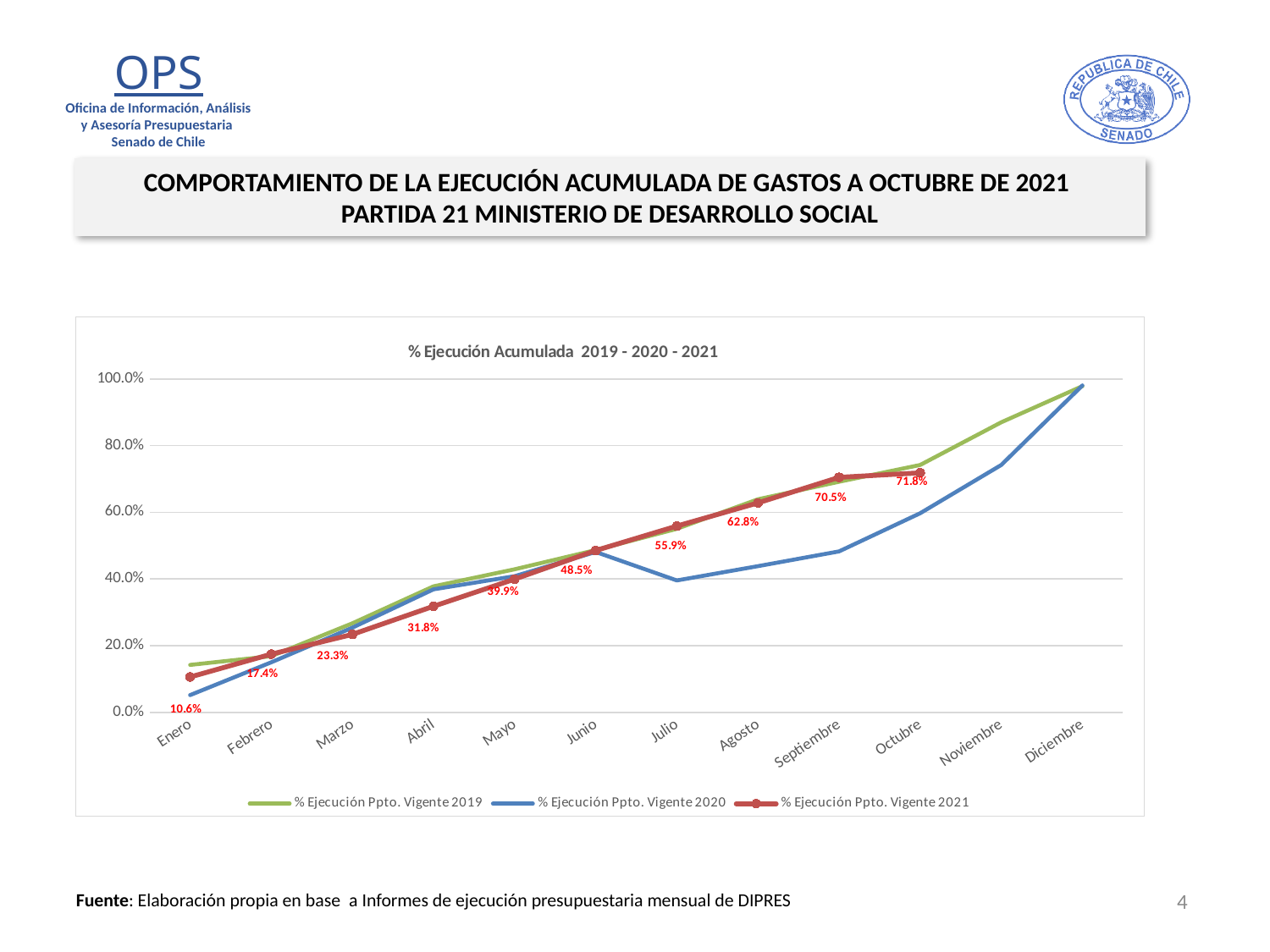
What is the value of % Ejecución Ppto. Vigente 2021 for Octubre? 71.8% What is the value of % Ejecución Ppto. Vigente 2021 for Agosto? 62.8% What is the difference between the 2021 values for Septiembre and Agosto? 7.7% What is the value of % Ejecución Ppto. Vigente 2021 for Enero? 10.6% Does the % Ejecución Ppto. Vigente 2021 series rise or fall from Enero to Octubre? Rise How many series does the legend list? 3 Which month has the lowest value for the % Ejecución Ppto. Vigente 2021 series? Enero What is the difference between the 2021 values for Octubre and Enero? 61.2% What is the value of % Ejecución Ppto. Vigente 2021 for Junio? 48.5% Which month has the highest value for the % Ejecución Ppto. Vigente 2021 series? Octubre What kind of chart is shown on the slide? Line chart